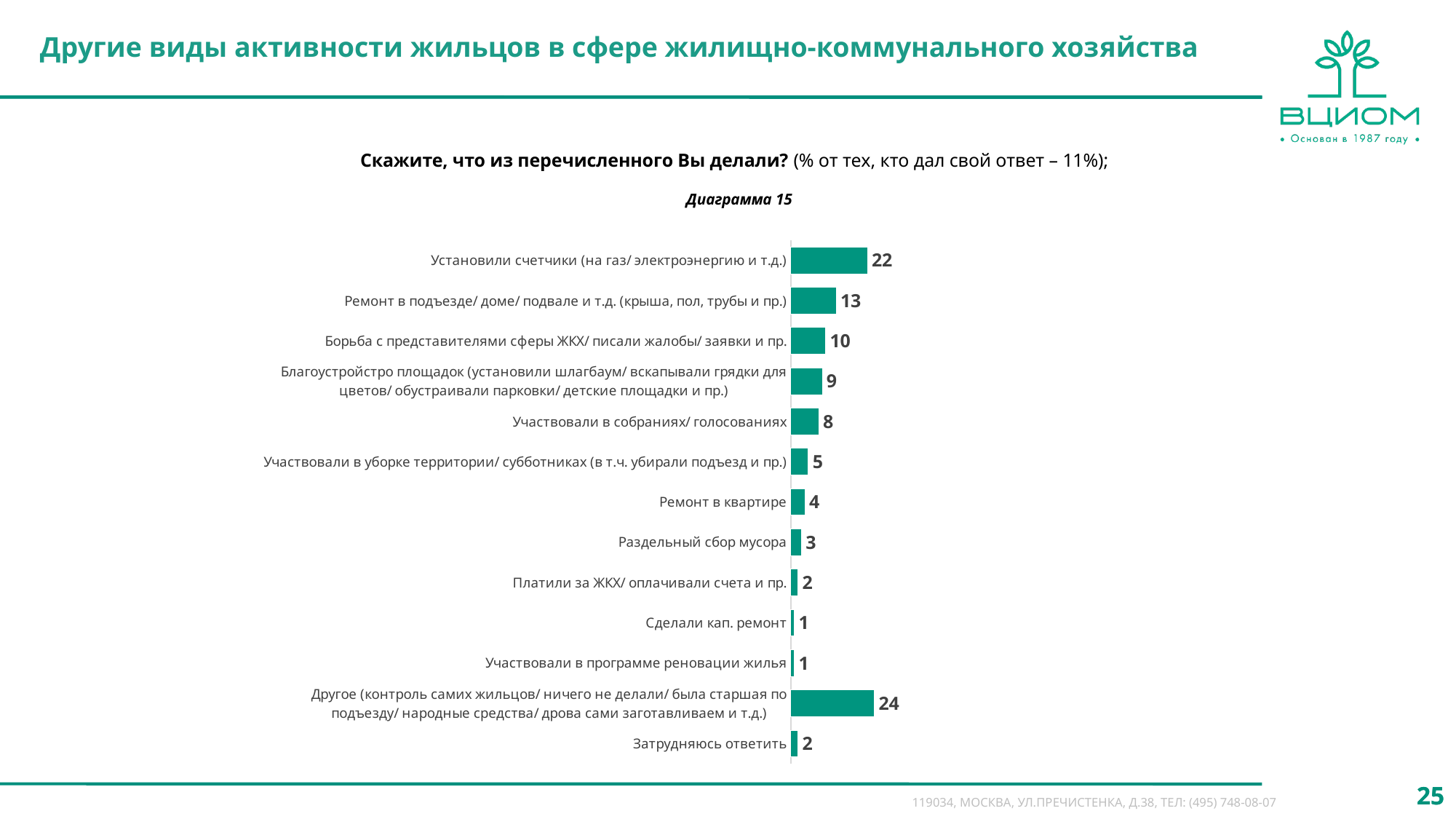
How many categories are shown in the chart? 13 What value is shown for «Затрудняюсь ответить»? 2 What is the difference between the values for «Другое» and «Установили счетчики»? 2 Which category has the highest value in the chart? Другое (контроль самих жильцов/ ничего не делали/ была старшая по подъезду/ народные средства/ дрова сами заготавливаем и т.д.) Which is larger: the value for «Борьба с представителями сферы ЖКХ» or the value for «Участвовали в уборке территории/ субботниках»? Борьба с представителями сферы ЖКХ What value is shown for «Участвовали в собраниях/ голосованиях»? 8 What is the label printed directly above the chart? Диаграмма 15 What value is shown for «Ремонт в подъезде/ доме/ подвале и т.д. (крыша, пол, трубы и пр.)»? 13 What is the lowest value shown in the chart? 1 What is the difference between the values for «Установили счетчики» and «Ремонт в подъезде/ доме/ подвале»? 9 What kind of chart is shown on the slide? Bar chart What value is shown for «Установили счетчики (на газ/ электроэнергию и т.д.)»? 22